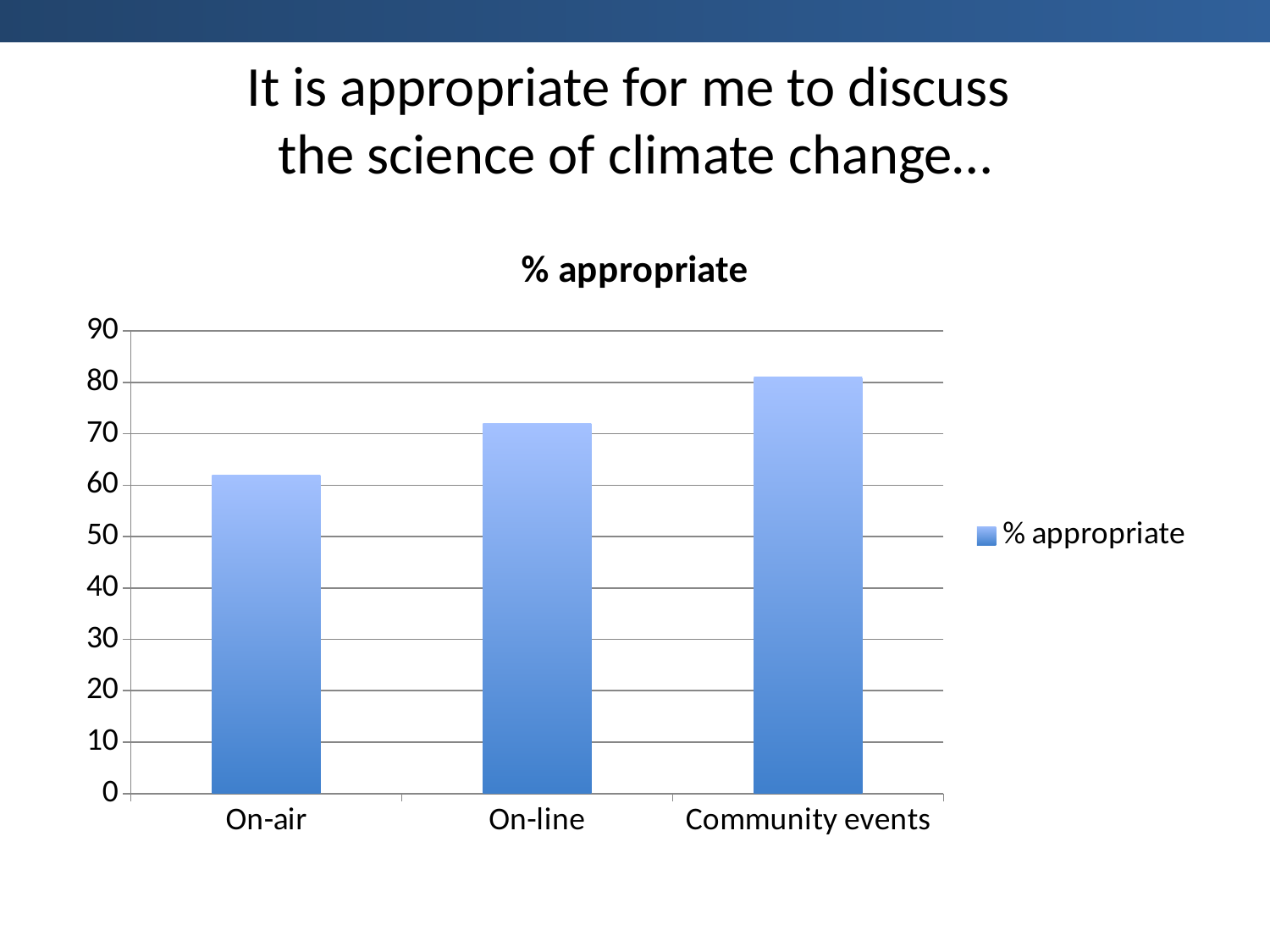
What is the title of the chart? % appropriate Is the value for Community events greater or less than 70? greater Which category has the highest value in the chart? Community events How many categories are shown on the x axis of the chart? 3 How many series does the chart legend list? 1 Which is larger, the value for On-line or the value for On-air? On-line Is the value for On-line greater or less than 80? less What type of chart is shown on the slide? bar chart Which category has the lowest value in the chart? On-air Is the value for On-air greater or less than 70? less Do the values rise or fall moving from On-air to Community events along the x axis? rise